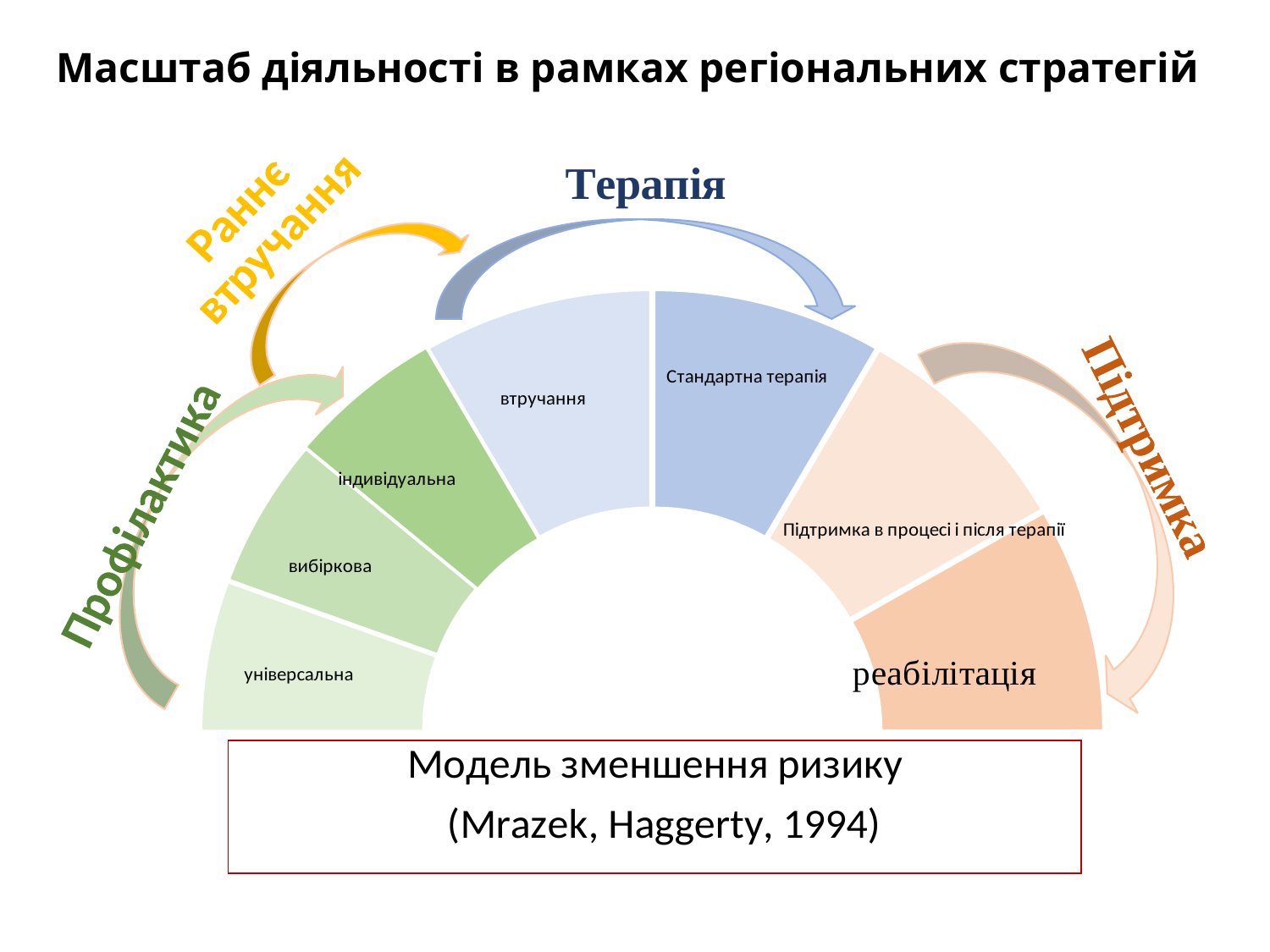
What is the label of the leftmost (lowest) green segment of the diagram? універсальна What is the label of the dark blue segment at the top of the diagram? Стандартна терапія What is the label of the rightmost (lowest) orange segment of the diagram? реабілітація How many top-level stages are labelled with arrows around the diagram? 4 What model is named in the box below the diagram? Модель зменшення ризику (Mrazek, Haggerty, 1994) Which stage label is written in green on the left side of the diagram? Профілактика How many segments make up the semicircular diagram? 7